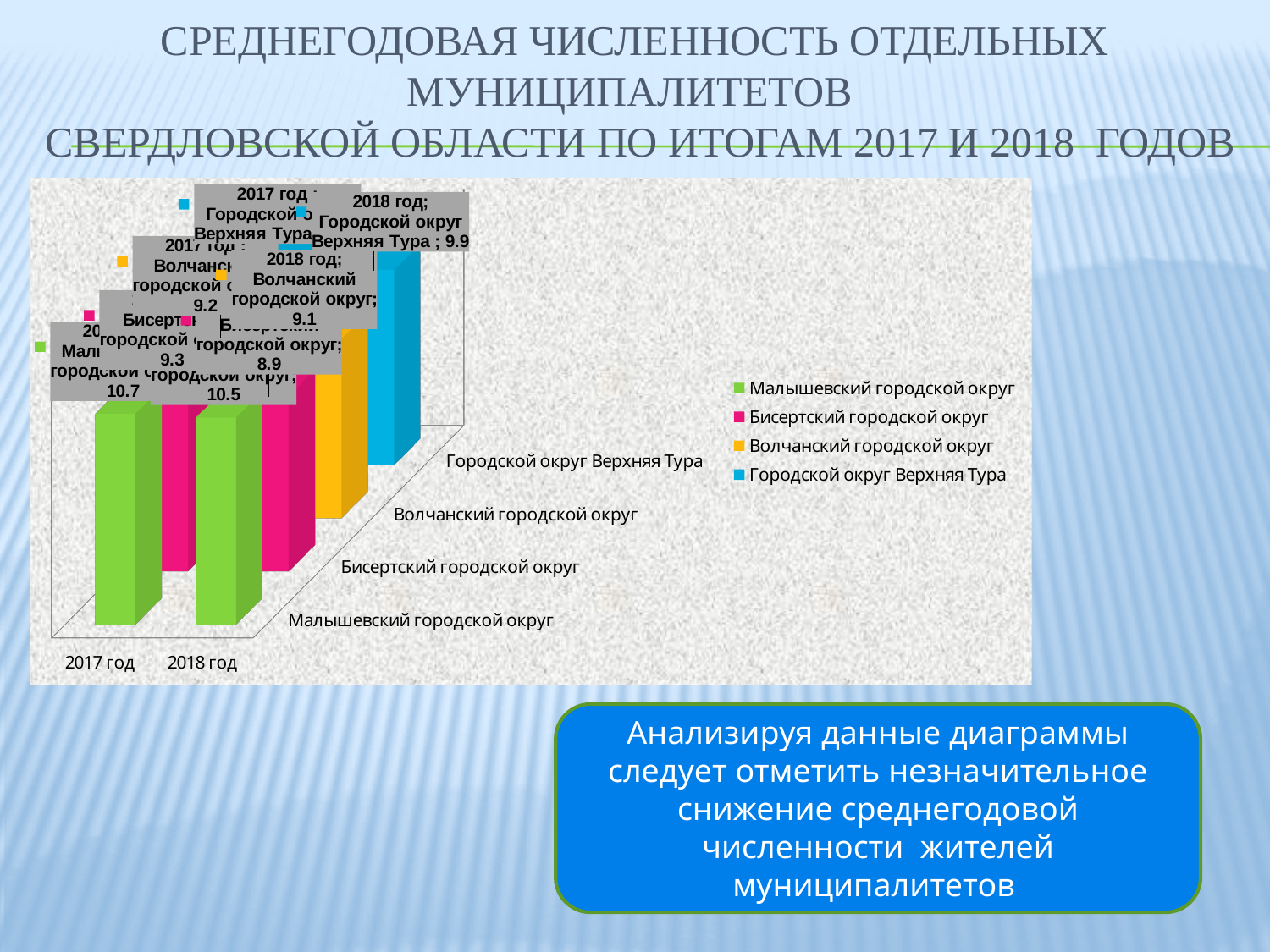
How many series does the legend list? 4 Which series has the highest value in 2018 год? Малышевский городской округ What is the value for Малышевский городской округ in 2017 год? 10.7 What kind of chart is shown on the slide? bar chart What is the value for Малышевский городской округ in 2018 год? 10.5 Does the value for Малышевский городской округ rise or fall from 2017 год to 2018 год? fall What is the difference between the 2017 год and 2018 год values for Бисертский городской округ? 0.4 Which series has the lowest value in 2018 год? Бисертский городской округ What is the value for Волчанский городской округ in 2018 год? 9.1 By how much did the value for Малышевский городской округ change between 2017 год and 2018 год? 0.2 What is the value for Городской округ Верхняя Тура in 2018 год? 9.9 What is the value for Бисертский городской округ in 2018 год? 8.9